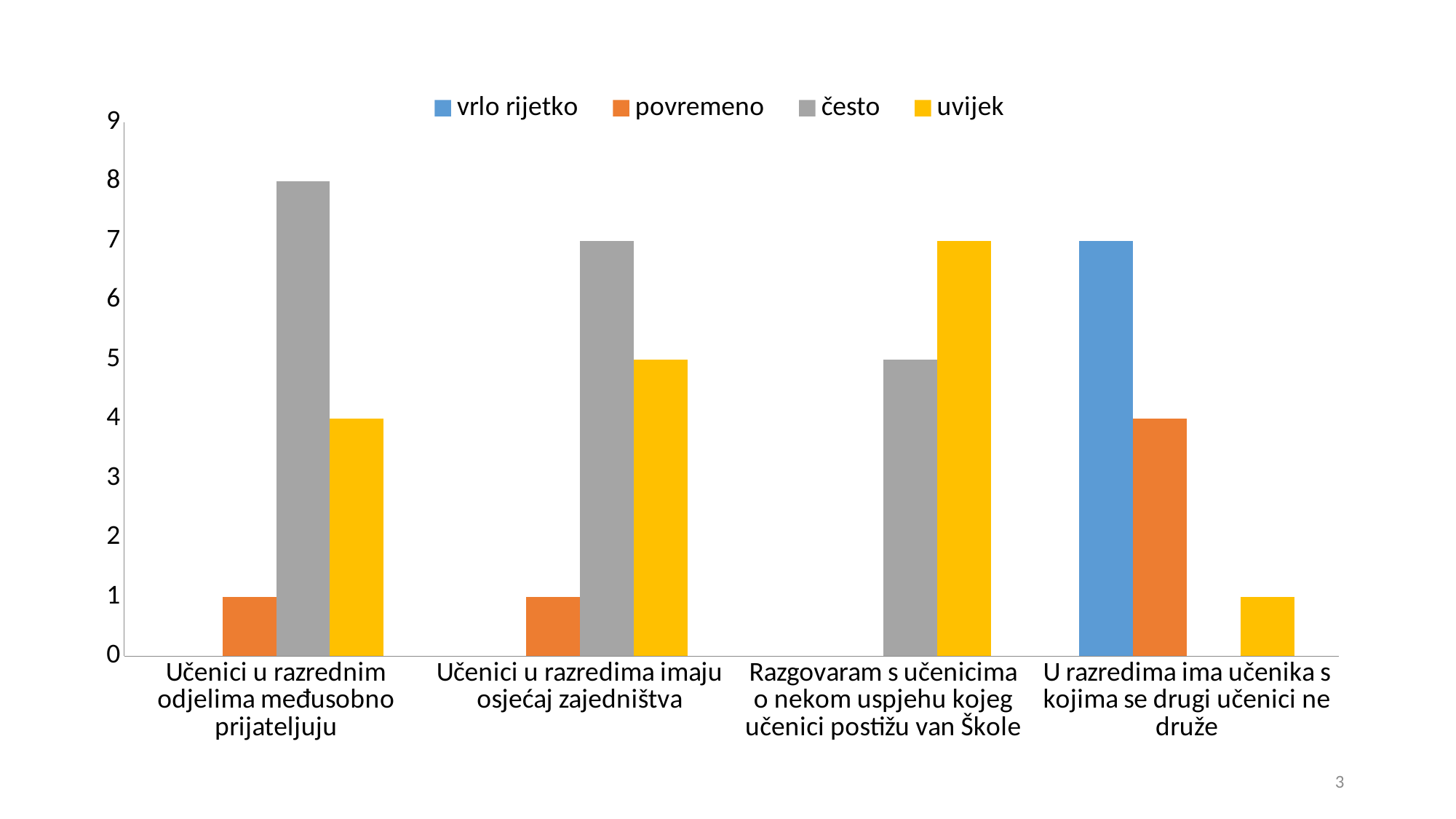
Which legend entry is shown in yellow? uvijek What is the value of 'povremeno' for 'U razredima ima učenika s kojima se drugi učenici ne druže'? 4 What is the difference between 'često' and 'uvijek' for 'Učenici u razrednim odjelima međusobno prijateljuju'? 4 How many series does the legend list? 4 What is the value of 'često' for 'Učenici u razrednim odjelima međusobno prijateljuju'? 8 What kind of chart is shown on the slide? bar chart What is the value of 'vrlo rijetko' for 'U razredima ima učenika s kojima se drugi učenici ne druže'? 7 How many categories are shown on the x axis? 4 What is the value of 'uvijek' for 'Učenici u razredima imaju osjećaj zajedništva'? 5 Which is larger for 'Razgovaram s učenicima o nekom uspjehu kojeg učenici postižu van Škole': 'često' or 'uvijek'? uvijek Which series has the lowest value for 'Učenici u razredima imaju osjećaj zajedništva'? povremeno Which series has the highest value for 'Razgovaram s učenicima o nekom uspjehu kojeg učenici postižu van Škole'? uvijek